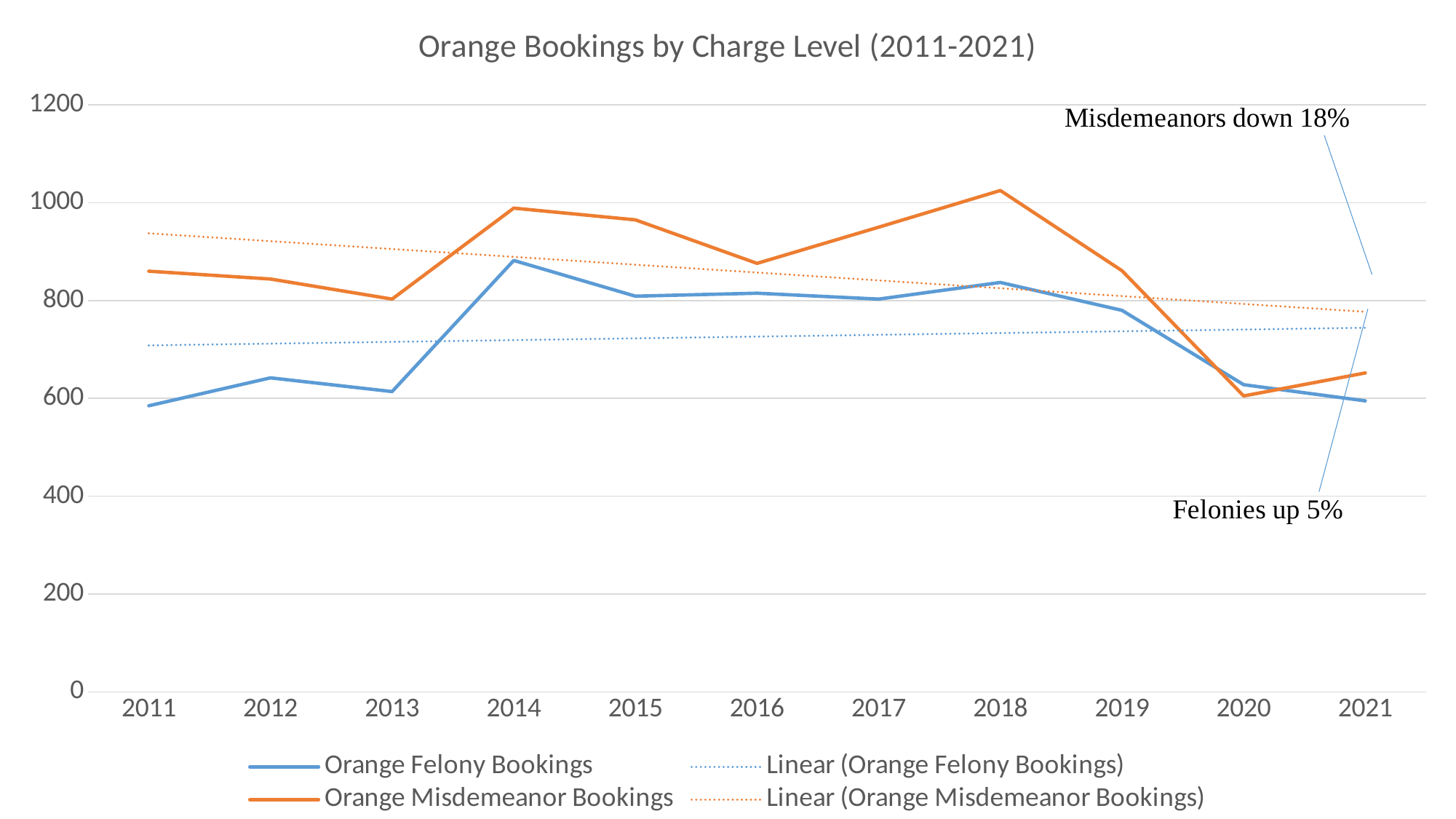
Is the value for Orange Misdemeanor Bookings in 2020 greater or less than 800? less Does the linear trendline for Orange Misdemeanor Bookings rise or fall from 2011 to 2021? fall In which year were Orange Misdemeanor Bookings lowest? 2020 What does the annotation on the chart say about misdemeanors? Misdemeanors down 18% Is the value for Orange Misdemeanor Bookings in 2018 greater or less than 1000? greater What type of chart is shown on the slide? line chart How many years are plotted along the x axis? 11 In which year were Orange Misdemeanor Bookings highest? 2018 How many series does the legend list? 4 In 2014, which series had the larger value: Orange Felony Bookings or Orange Misdemeanor Bookings? Orange Misdemeanor Bookings In which year were Orange Felony Bookings highest? 2014 Is the value for Orange Felony Bookings in 2011 greater or less than 600? less